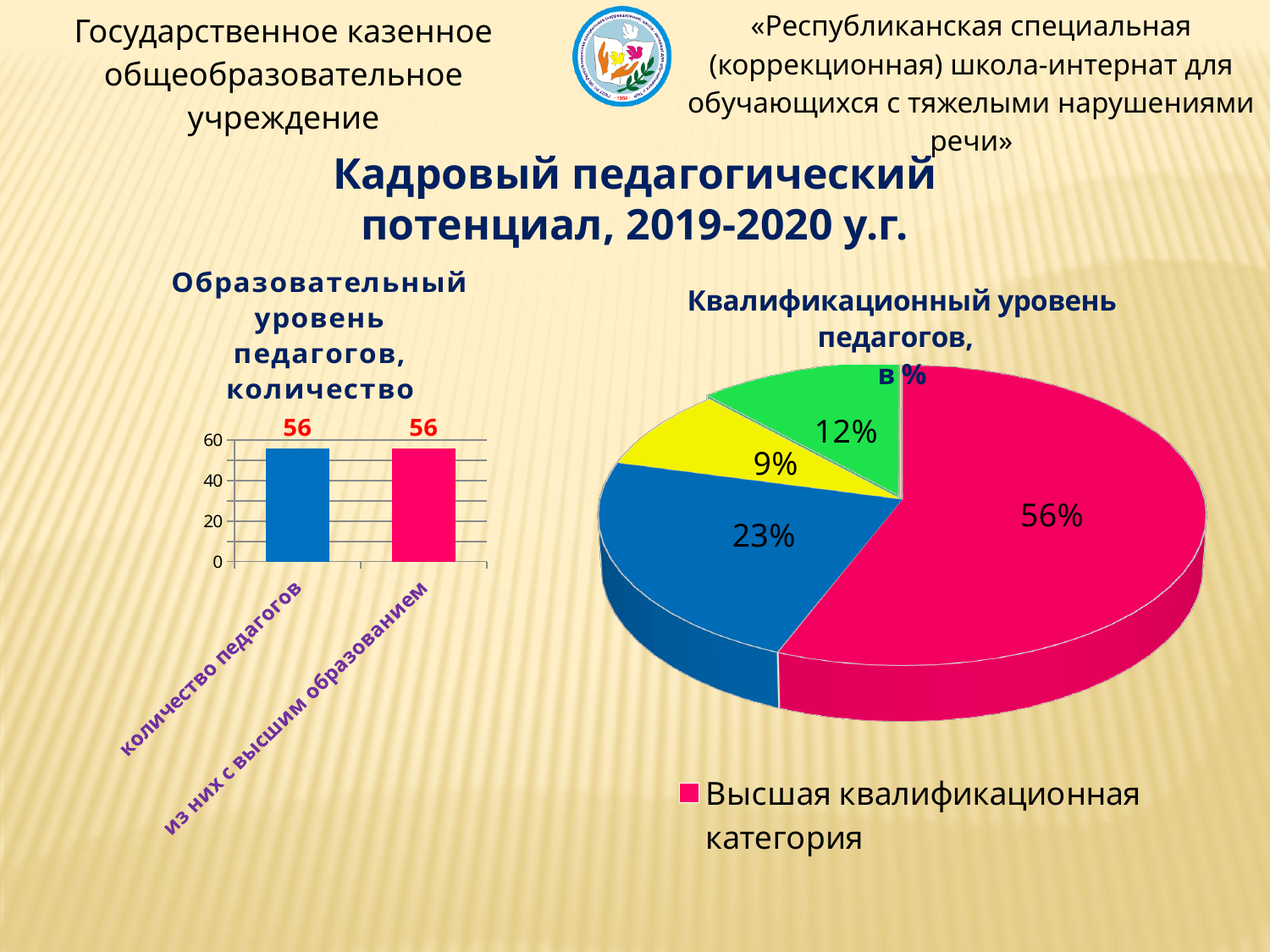
In the bar chart 'Образовательный уровень педагогов, количество', what is the value for 'из них с высшим образованием'? 56 What kind of chart is 'Образовательный уровень педагогов, количество'? bar chart How many bars are shown in the bar chart 'Образовательный уровень педагогов, количество'? 2 In the pie chart 'Квалификационный уровень педагогов, в %', what is the difference between the largest slice (56%) and the blue slice (23%)? 33% In the pie chart 'Квалификационный уровень педагогов, в %', what is the share of the largest slice? 56% In the bar chart 'Образовательный уровень педагогов, количество', what is the value for 'количество педагогов'? 56 In the pie chart 'Квалификационный уровень педагогов, в %', what is the share of the smallest slice? 9% In the pie chart 'Квалификационный уровень педагогов, в %', what is the share of the slice labelled 'Высшая квалификационная категория'? 56% How many slices does the pie chart 'Квалификационный уровень педагогов, в %' have? 4 In the pie chart 'Квалификационный уровень педагогов, в %', which is larger: the green slice or the yellow slice? the green slice (12%) What is the only legend entry shown for the pie chart 'Квалификационный уровень педагогов, в %'? Высшая квалификационная категория What kind of chart is 'Квалификационный уровень педагогов, в %'? pie chart